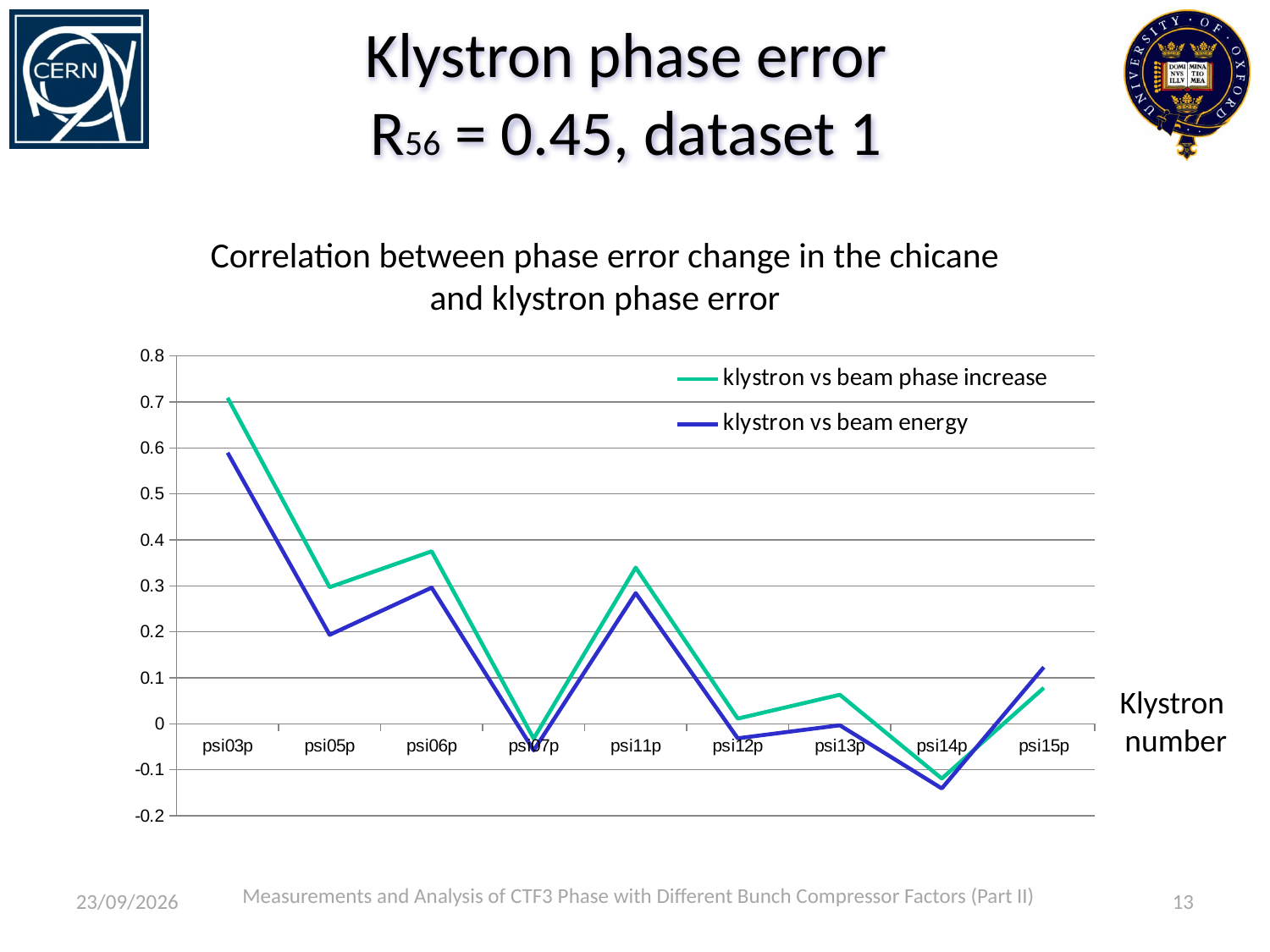
What label is shown next to the x axis of the chart? Klystron number Does the 'klystron vs beam phase increase' series rise or fall from psi03p to psi05p? fall How many klystron categories are plotted along the x axis? 9 For the 'klystron vs beam phase increase' series, which klystron has the lowest value? psi14p Is the 'klystron vs beam phase increase' value for psi03p greater or less than 0.6? greater Is the 'klystron vs beam energy' value for psi05p greater or less than 0.3? less For the 'klystron vs beam phase increase' series, which klystron has the highest value? psi03p What kind of chart is shown on the slide? line chart At psi06p, which series has the larger value: 'klystron vs beam phase increase' or 'klystron vs beam energy'? klystron vs beam phase increase Is the 'klystron vs beam energy' value for psi14p greater or less than 0? less For the 'klystron vs beam energy' series, which klystron has the highest value? psi03p How many series does the chart legend list? 2